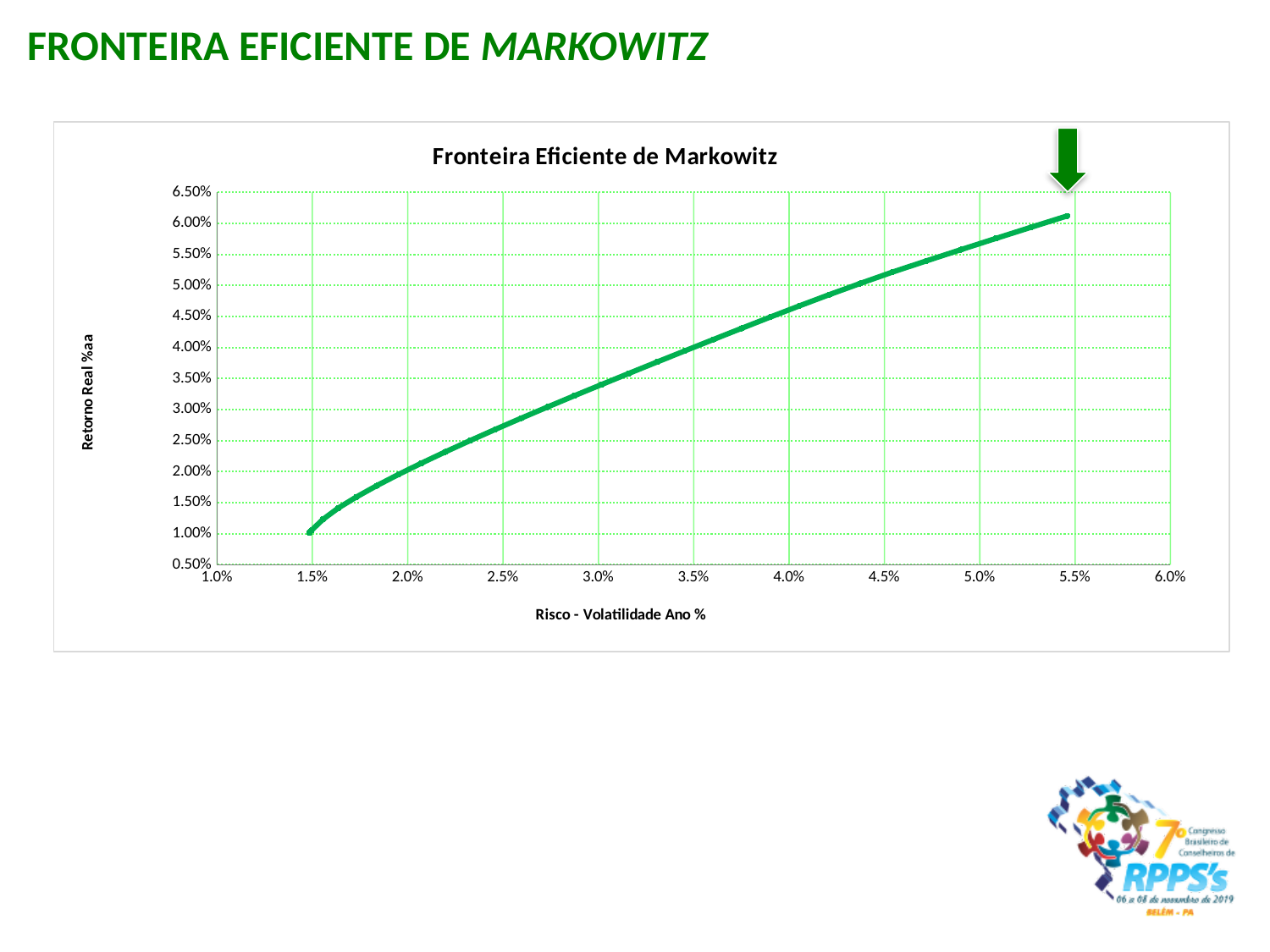
What is the label of the horizontal axis? Risco - Volatilidade Ano % At a risk of 2.0%, is the return on the curve greater or less than 2.50%? less At a risk of 3.0%, is the return on the curve greater or less than 4.00%? less Is the lowest return on the curve greater or less than 1.50%? less What is the title of the chart? Fronteira Eficiente de Markowitz What kind of chart is shown on the slide? line chart Is the return at a risk of 5.0% larger or smaller than the return at a risk of 2.5%? larger Does the return (Retorno Real %aa) rise or fall as risk (Risco - Volatilidade Ano %) increases along the x axis? rise